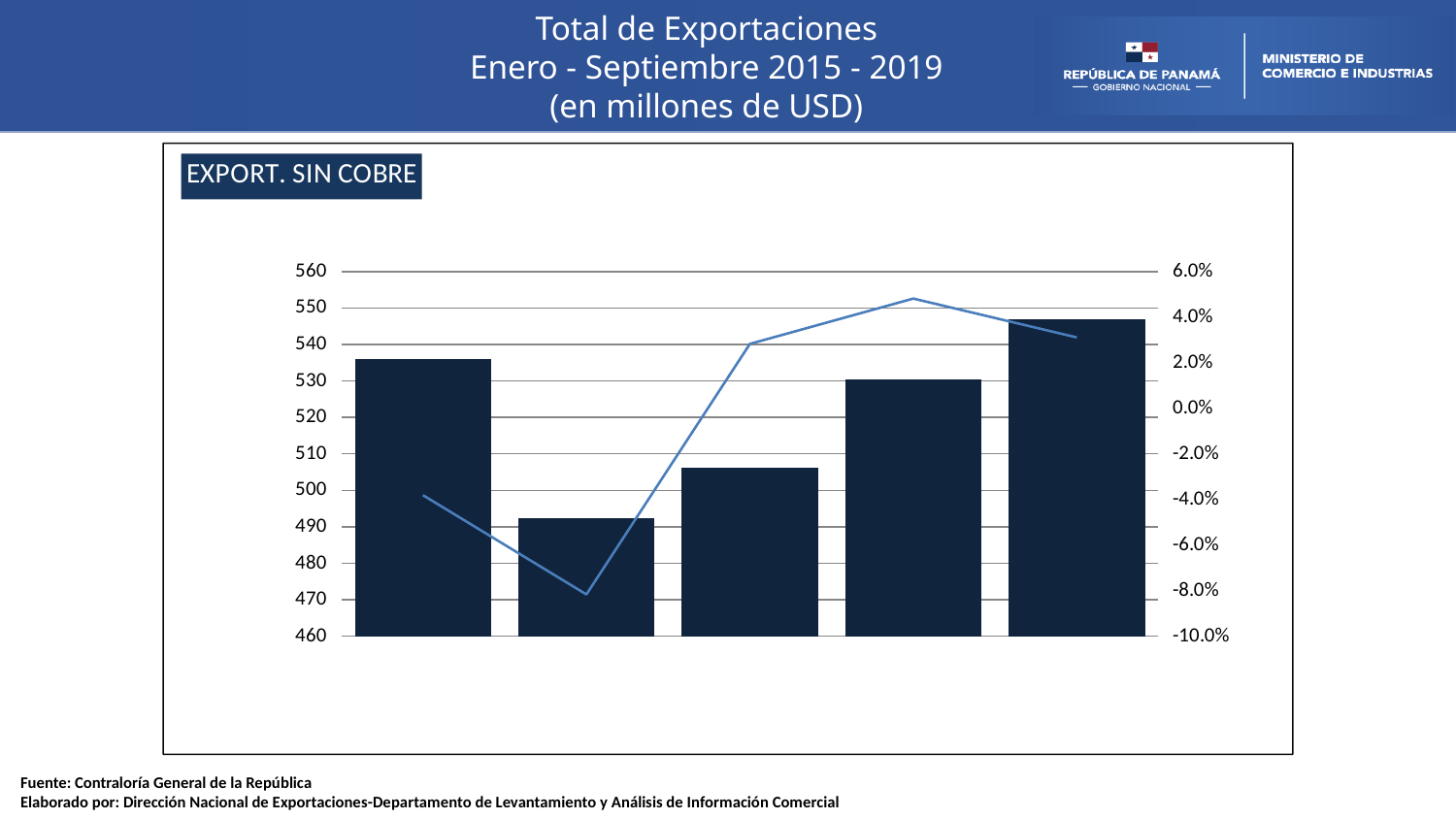
Which bar is the shortest in the chart? The second bar Which bar is the tallest in the chart? The fifth (rightmost) bar What is the title shown inside the chart box? EXPORT. SIN COBRE From the second bar to the fifth bar, do the bar values rise or fall? Rise How many bars are plotted in the chart? 5 Is the line's value at the second bar greater or less than -6.0%? less Is the value of the second bar greater or less than 500? less What kind of chart is shown on the slide? A bar chart combined with a line Is the value of the third bar greater or less than 500? greater Which is larger, the first bar or the second bar? The first bar